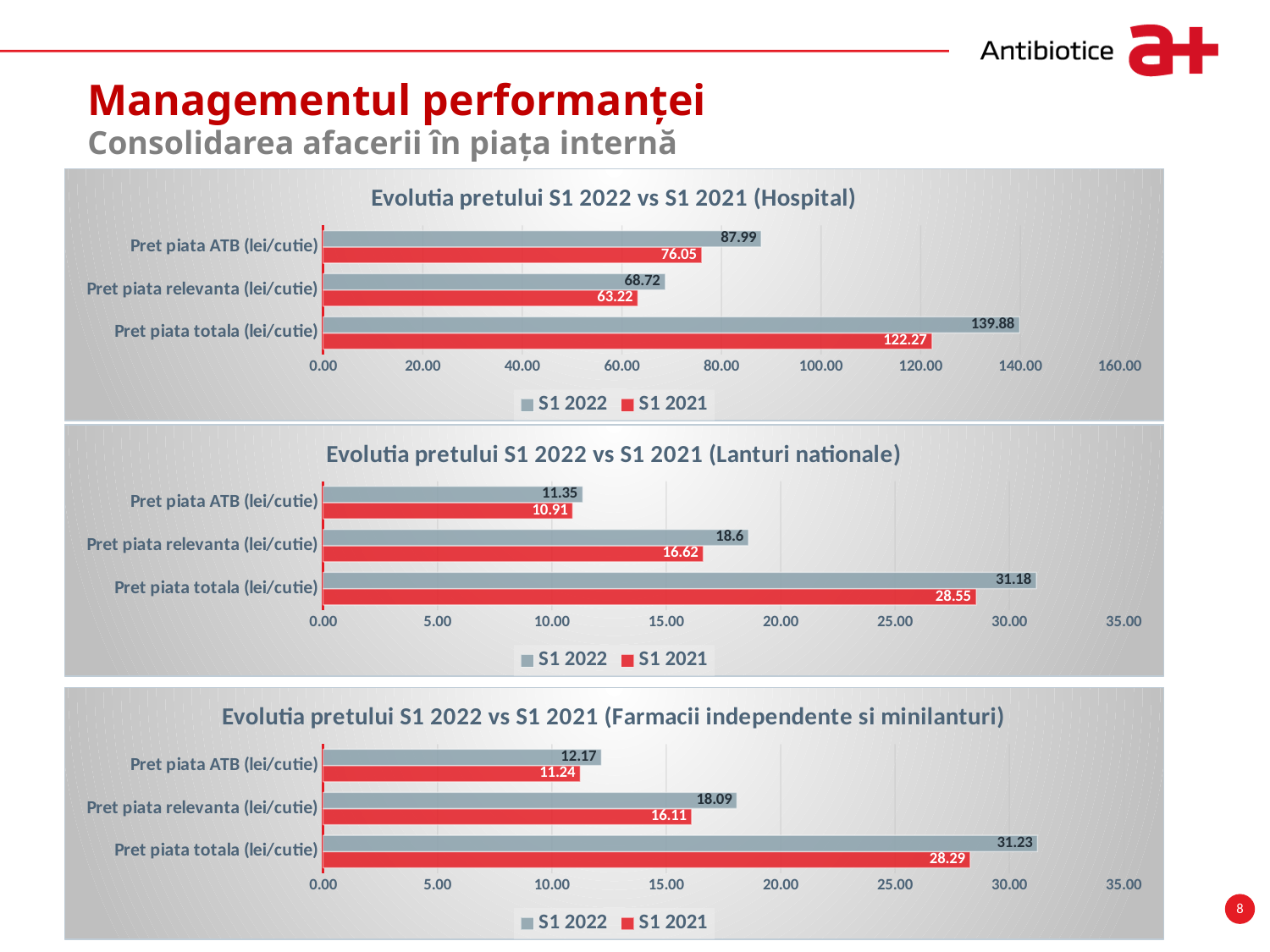
In the 'Evolutia pretului S1 2022 vs S1 2021 (Hospital)' chart, what is the S1 2022 value for Pret piata totala (lei/cutie)? 139.88 In the 'Evolutia pretului S1 2022 vs S1 2021 (Lanturi nationale)' chart, which category has the highest S1 2022 value? Pret piata totala (lei/cutie) In the 'Evolutia pretului S1 2022 vs S1 2021 (Farmacii independente si minilanturi)' chart, which is larger for Pret piata ATB (lei/cutie): the S1 2022 value or the S1 2021 value? S1 2022 In the 'Evolutia pretului S1 2022 vs S1 2021 (Hospital)' chart, what is the difference between the S1 2022 and S1 2021 values for Pret piata totala (lei/cutie)? 17.61 In the 'Evolutia pretului S1 2022 vs S1 2021 (Lanturi nationale)' chart, what is the S1 2021 value for Pret piata totala (lei/cutie)? 28.55 In the 'Evolutia pretului S1 2022 vs S1 2021 (Hospital)' chart, what is the S1 2021 value for Pret piata ATB (lei/cutie)? 76.05 In the 'Evolutia pretului S1 2022 vs S1 2021 (Lanturi nationale)' chart, what is the difference between the S1 2022 and S1 2021 values for Pret piata relevanta (lei/cutie)? 1.98 How many series does the legend list in the 'Evolutia pretului S1 2022 vs S1 2021 (Farmacii independente si minilanturi)' chart? 2 In the 'Evolutia pretului S1 2022 vs S1 2021 (Farmacii independente si minilanturi)' chart, what is the S1 2021 value for Pret piata relevanta (lei/cutie)? 16.11 What kind of chart is the 'Evolutia pretului S1 2022 vs S1 2021 (Hospital)' chart? Bar chart In the 'Evolutia pretului S1 2022 vs S1 2021 (Hospital)' chart, which category has the lowest S1 2021 value? Pret piata relevanta (lei/cutie) In the 'Evolutia pretului S1 2022 vs S1 2021 (Lanturi nationale)' chart, what is the S1 2022 value for Pret piata relevanta (lei/cutie)? 18.6